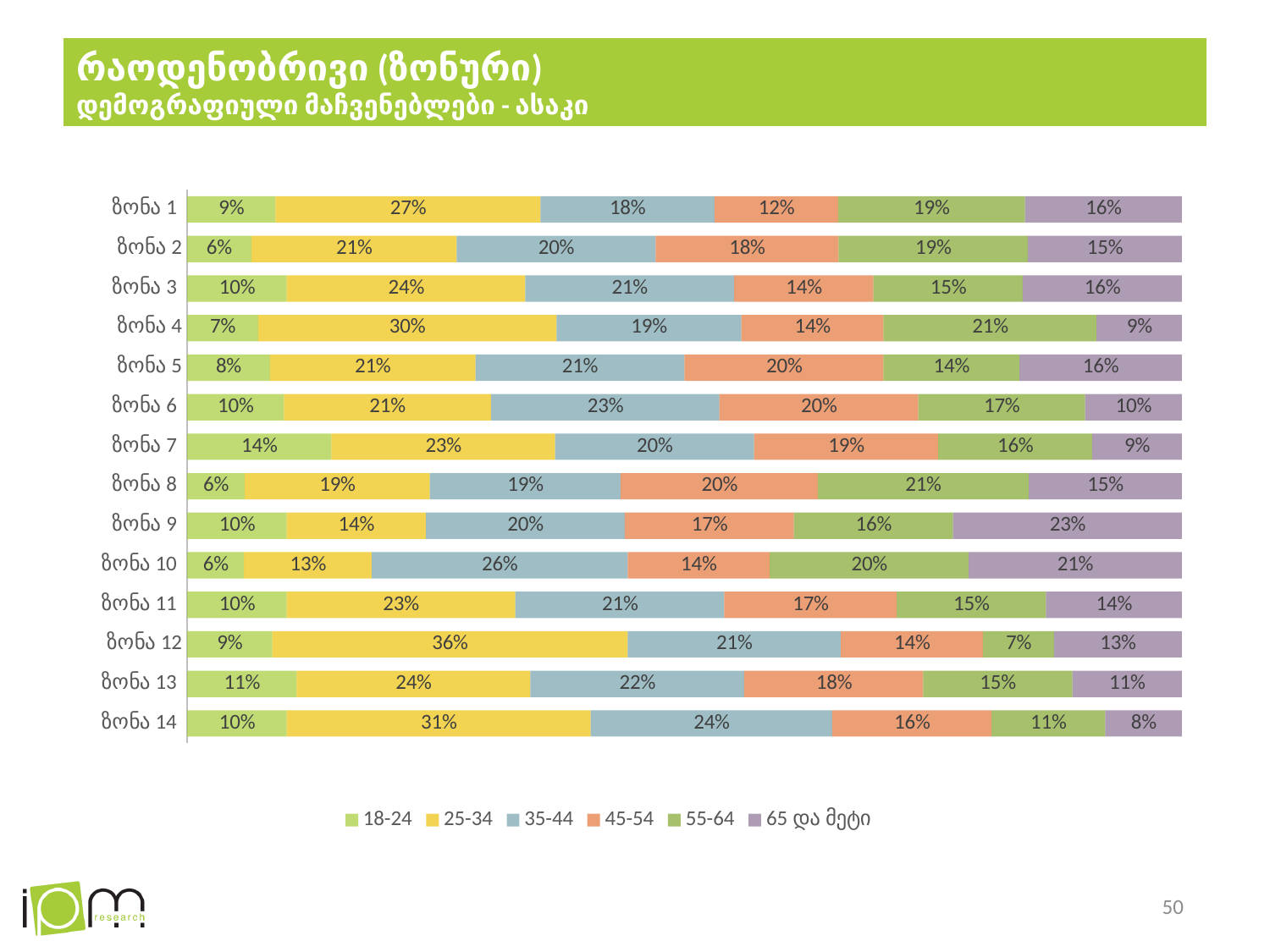
Which zone has the highest value for the 25-34 age group? ზონა 12 What share of ზონა 12 falls in the 55-64 age group? 7% What is the difference between the 35-44 values of ზონა 10 and ზონა 1? 8% Which age group is shown in yellow in the chart? 25-34 How many zones are shown in the chart? 14 How many age groups does the legend list? 6 Which zone has the lowest value for the 65 და მეტი age group? ზონა 14 What is the value for the 65 და მეტი age group in ზონა 9? 23% What type of chart is shown on the slide? Stacked bar chart Which zone has the highest value for the 18-24 age group? ზონა 7 Which is larger: the 45-54 value for ზონა 5 or for ზონა 1? ზონა 5 What percentage of ზონა 1 is in the 25-34 age group? 27%